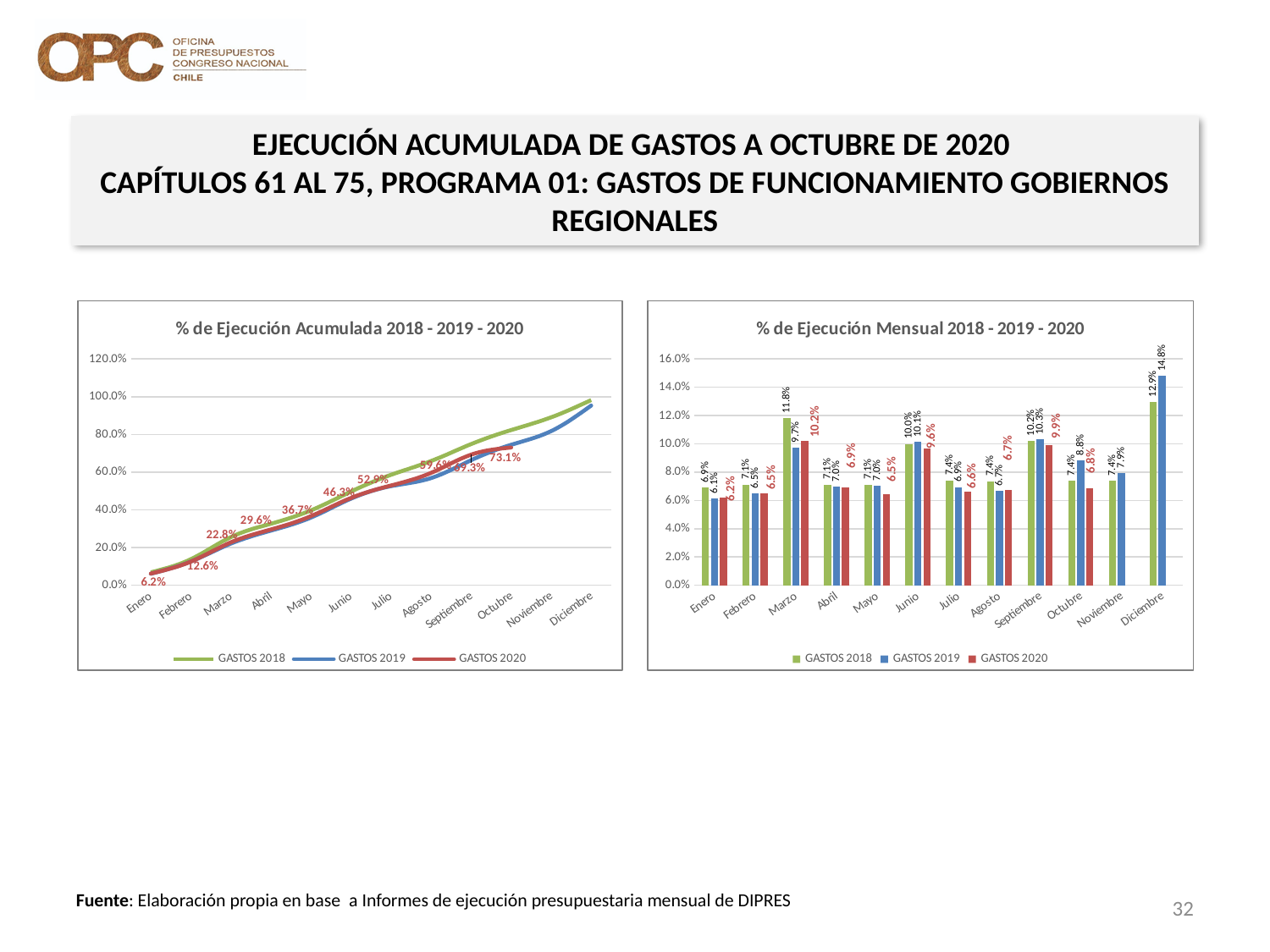
In the chart titled '% de Ejecución Acumulada 2018 - 2019 - 2020', what is the value for GASTOS 2020 in Enero? 6.2% In the chart titled '% de Ejecución Acumulada 2018 - 2019 - 2020', what is the value for GASTOS 2020 in Octubre? 73.1% In the chart titled '% de Ejecución Acumulada 2018 - 2019 - 2020', what kind of chart is shown? Line chart In the chart titled '% de Ejecución Mensual 2018 - 2019 - 2020', what is the value for GASTOS 2019 in Diciembre? 14.8% In the chart titled '% de Ejecución Acumulada 2018 - 2019 - 2020', how many series does the legend list? 3 In the chart titled '% de Ejecución Acumulada 2018 - 2019 - 2020', what is the difference between the GASTOS 2020 values for Septiembre and Agosto? 9.7% In the chart titled '% de Ejecución Mensual 2018 - 2019 - 2020', what is the value for GASTOS 2020 in Marzo? 10.2% In the chart titled '% de Ejecución Acumulada 2018 - 2019 - 2020', do the GASTOS 2020 values rise or fall from Enero to Octubre? Rise In the chart titled '% de Ejecución Mensual 2018 - 2019 - 2020', how many months are shown on the x axis? 12 In the chart titled '% de Ejecución Mensual 2018 - 2019 - 2020', which is larger in Octubre: GASTOS 2019 or GASTOS 2020? GASTOS 2019 In the chart titled '% de Ejecución Acumulada 2018 - 2019 - 2020', what is the value for GASTOS 2020 in Junio? 46.3% In the chart titled '% de Ejecución Mensual 2018 - 2019 - 2020', which month has the highest value for GASTOS 2018? Diciembre